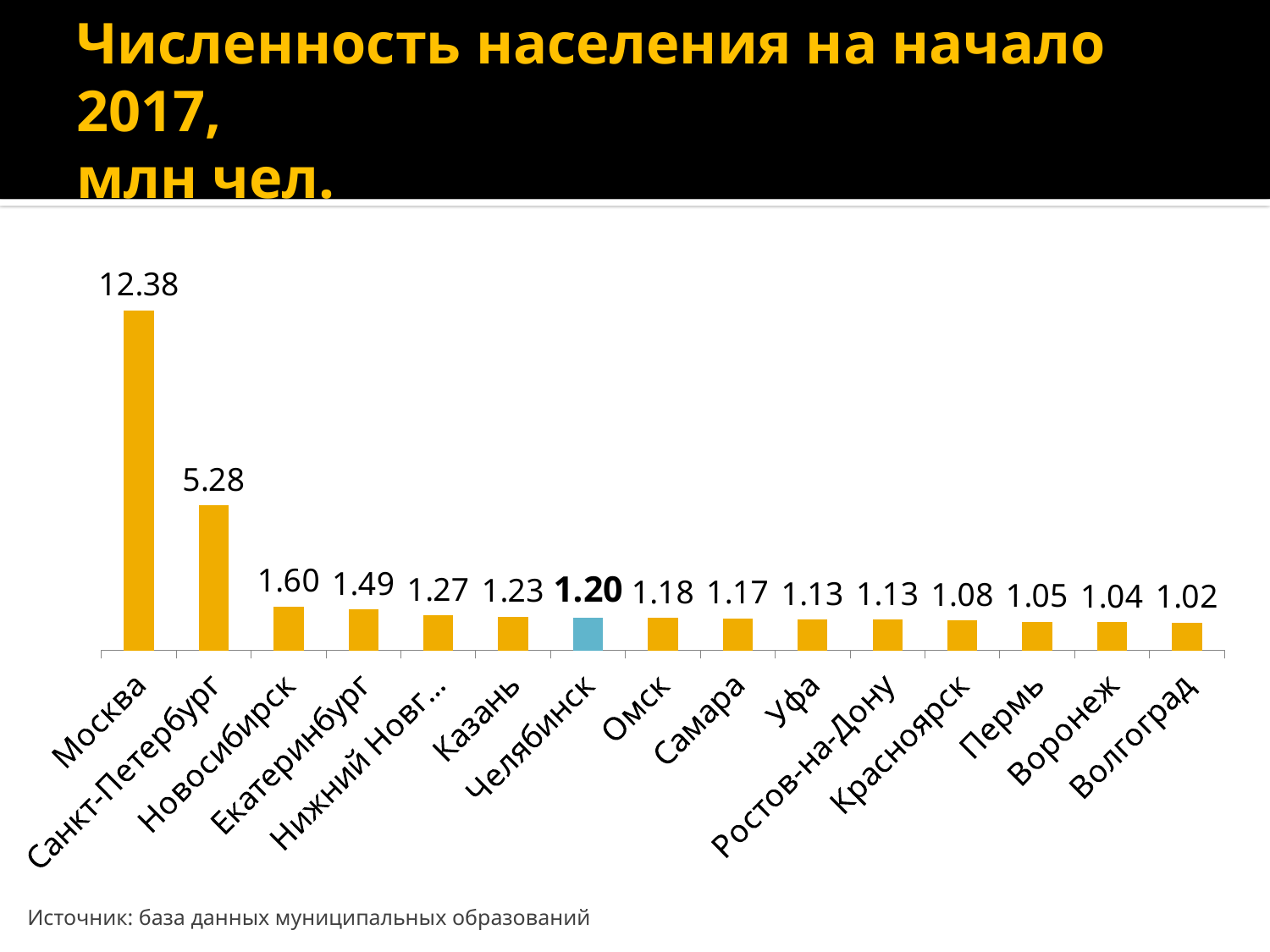
What is the value shown for Челябинск? 1.20 Which has a larger value, Казань or Омск? Казань Which city has the lowest value on the chart? Волгоград How many cities are shown on the chart? 15 What is the value shown for Красноярск? 1.08 What is the value shown for Санкт-Петербург? 5.28 What is the value shown for Москва? 12.38 Which city has the highest value on the chart? Москва What type of chart is shown on the slide? Bar chart Which city's bar is shown in a different colour (blue) from the others? Челябинск What is the difference between the values for Москва and Санкт-Петербург? 7.10 What is the difference between the values for Новосибирск and Екатеринбург? 0.11